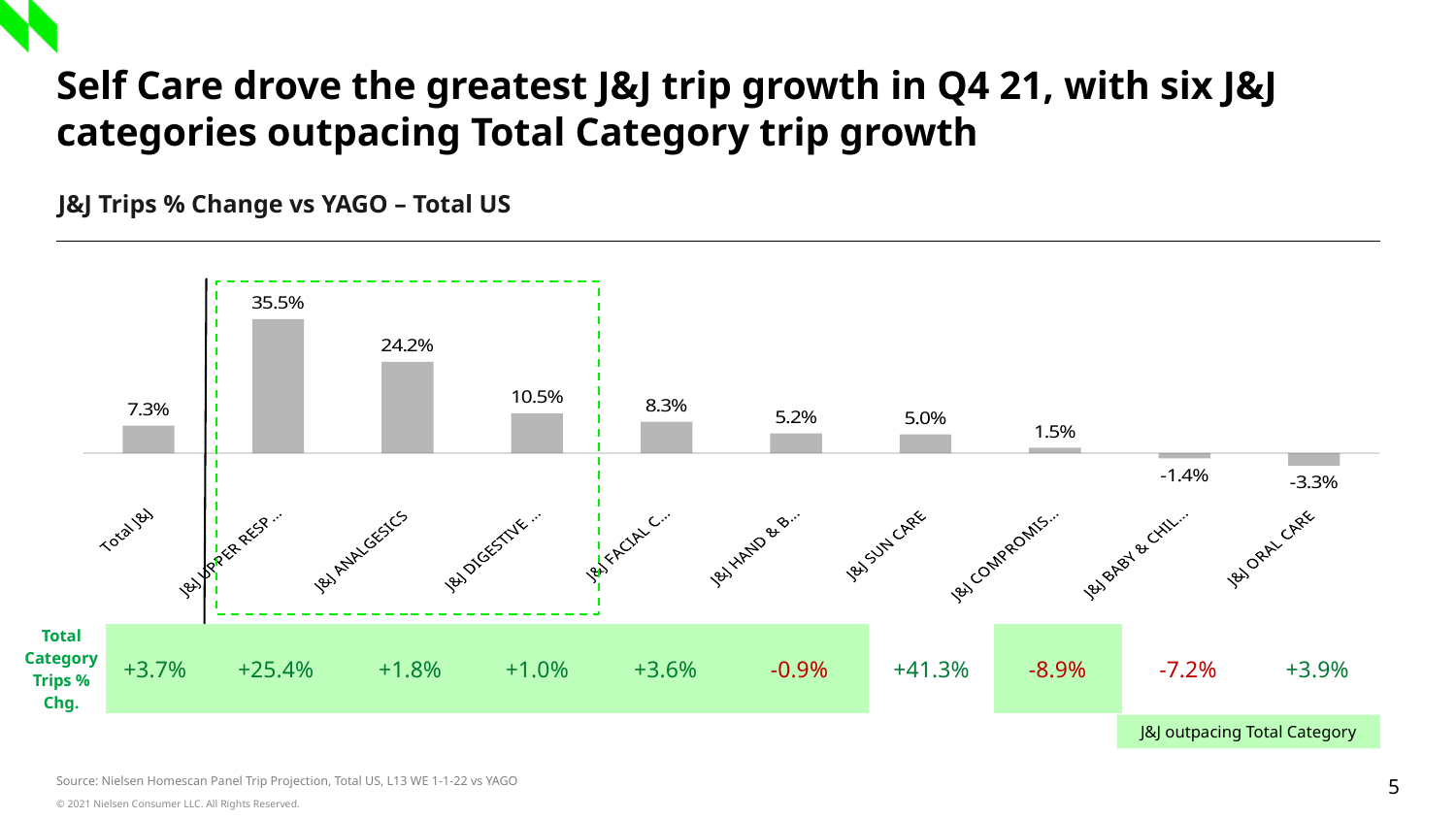
What is the difference between the values for J&J ANALGESICS and Total J&J? 16.9 percentage points Which category has the lowest J&J trips % change vs YAGO? J&J ORAL CARE What kind of chart is shown on the slide? Bar chart How many bars on the chart show a negative value? 2 Which has a larger J&J trips % change: J&J SUN CARE or J&J ORAL CARE? J&J SUN CARE What is the J&J trips % change vs YAGO for J&J SUN CARE? 5.0% What is the J&J trips % change vs YAGO for J&J ANALGESICS? 24.2% What is the J&J trips % change vs YAGO for J&J ORAL CARE? -3.3% What is the title of the chart? J&J Trips % Change vs YAGO – Total US What is the highest value shown on the bar chart? 35.5% How many categories are plotted on the bar chart? 10 What is the J&J trips % change vs YAGO for Total J&J? 7.3%